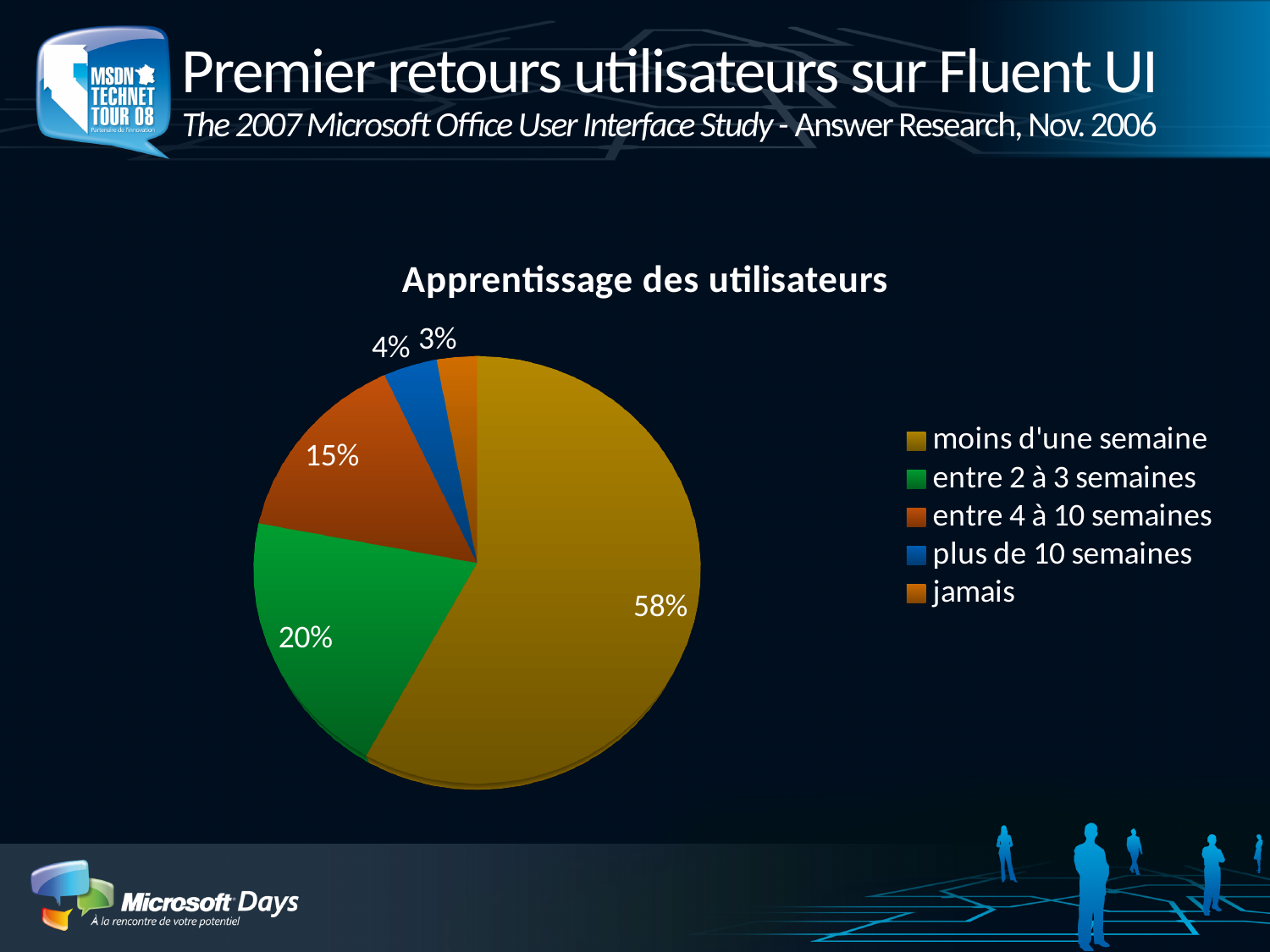
How many categories does the legend list? 5 Which is larger, the share for "entre 2 à 3 semaines" or the share for "entre 4 à 10 semaines"? entre 2 à 3 semaines What share of the pie is labelled "entre 4 à 10 semaines"? 15% Which category has the smallest slice of the pie? jamais What is the title of the chart? Apprentissage des utilisateurs Which category has the largest slice of the pie? moins d'une semaine What share of the pie is labelled "entre 2 à 3 semaines"? 20% What share of the pie is labelled "moins d'une semaine"? 58% What is the difference between the shares for "moins d'une semaine" and "entre 2 à 3 semaines"? 38% What kind of chart is shown on the slide? pie chart